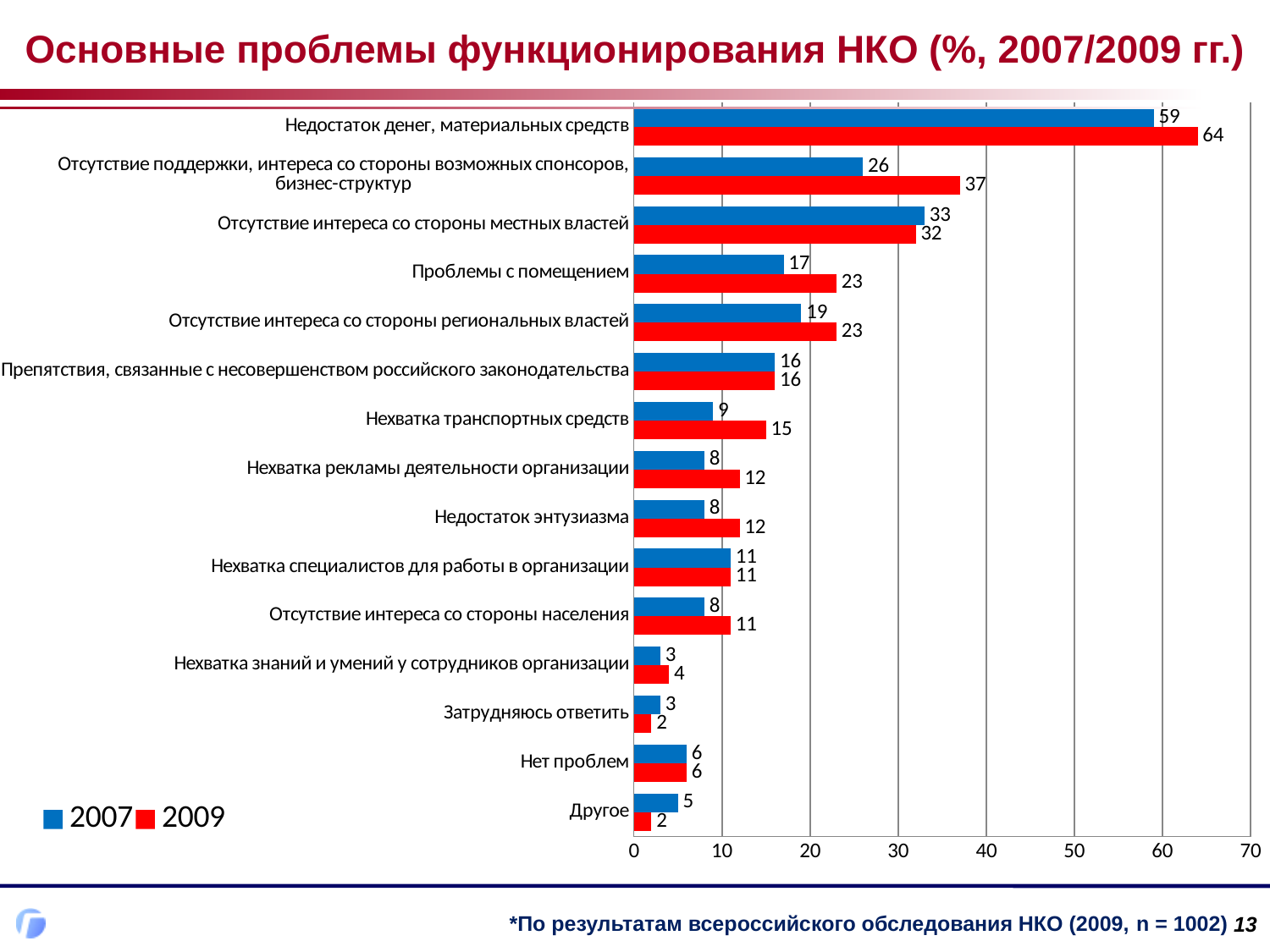
What is the 2009 value for "Нехватка транспортных средств"? 15 What is the difference between the 2009 and 2007 values for "Отсутствие поддержки, интереса со стороны возможных спонсоров, бизнес-структур"? 11 Is the 2009 value for "Проблемы с помещением" greater or less than 20? greater How many series does the legend list? 2 How many categories are plotted on the chart? 15 What is the 2009 value for "Недостаток денег, материальных средств"? 64 What kind of chart is shown on the slide? Bar chart For "Отсутствие интереса со стороны местных властей", which year has the larger value, 2007 or 2009? 2007 What is the 2007 value for "Отсутствие поддержки, интереса со стороны возможных спонсоров, бизнес-структур"? 26 Which colour represents the 2009 series in the legend? Red Which category has the lowest 2009 value? Затрудняюсь ответить and Другое (both 2) Which category has the highest 2007 value? Недостаток денег, материальных средств